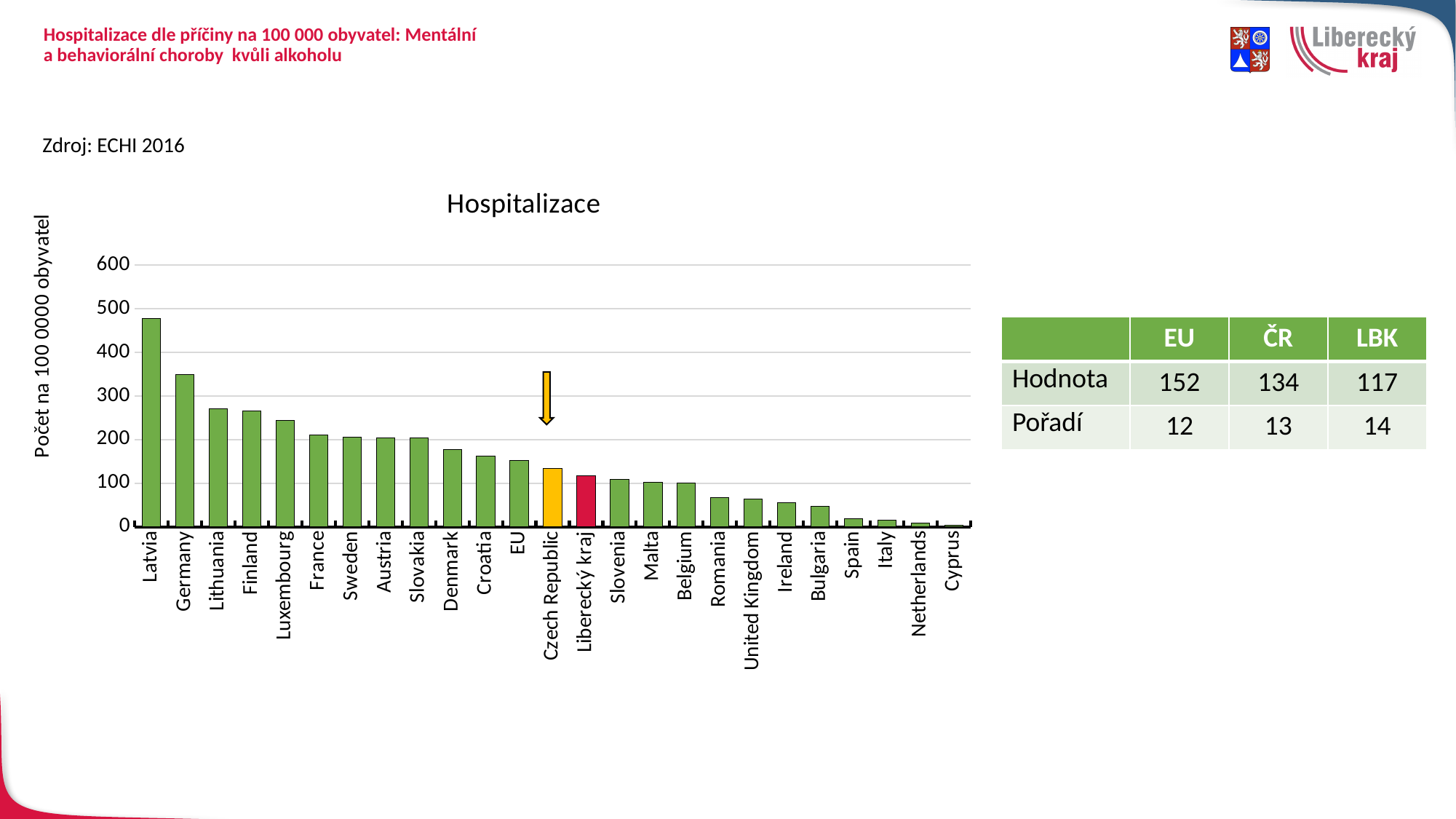
What is the difference between the EU value and the ČR value? 18 What is the value for Czech Republic (ČR) according to the slide? 134 What kind of chart is shown on the slide? bar chart Do the values rise or fall from left to right along the x axis? fall Which category has the highest value in the chart? Latvia Which category has the lowest value in the chart? Cyprus Which has a larger value, Germany or Lithuania? Germany How many countries/categories are plotted on the x axis of the chart? 25 What is the title of the chart? Hospitalizace Is the value for Latvia greater or less than 400? greater What is the value for Liberecký kraj (LBK) according to the slide? 117 What is the value for EU according to the slide? 152